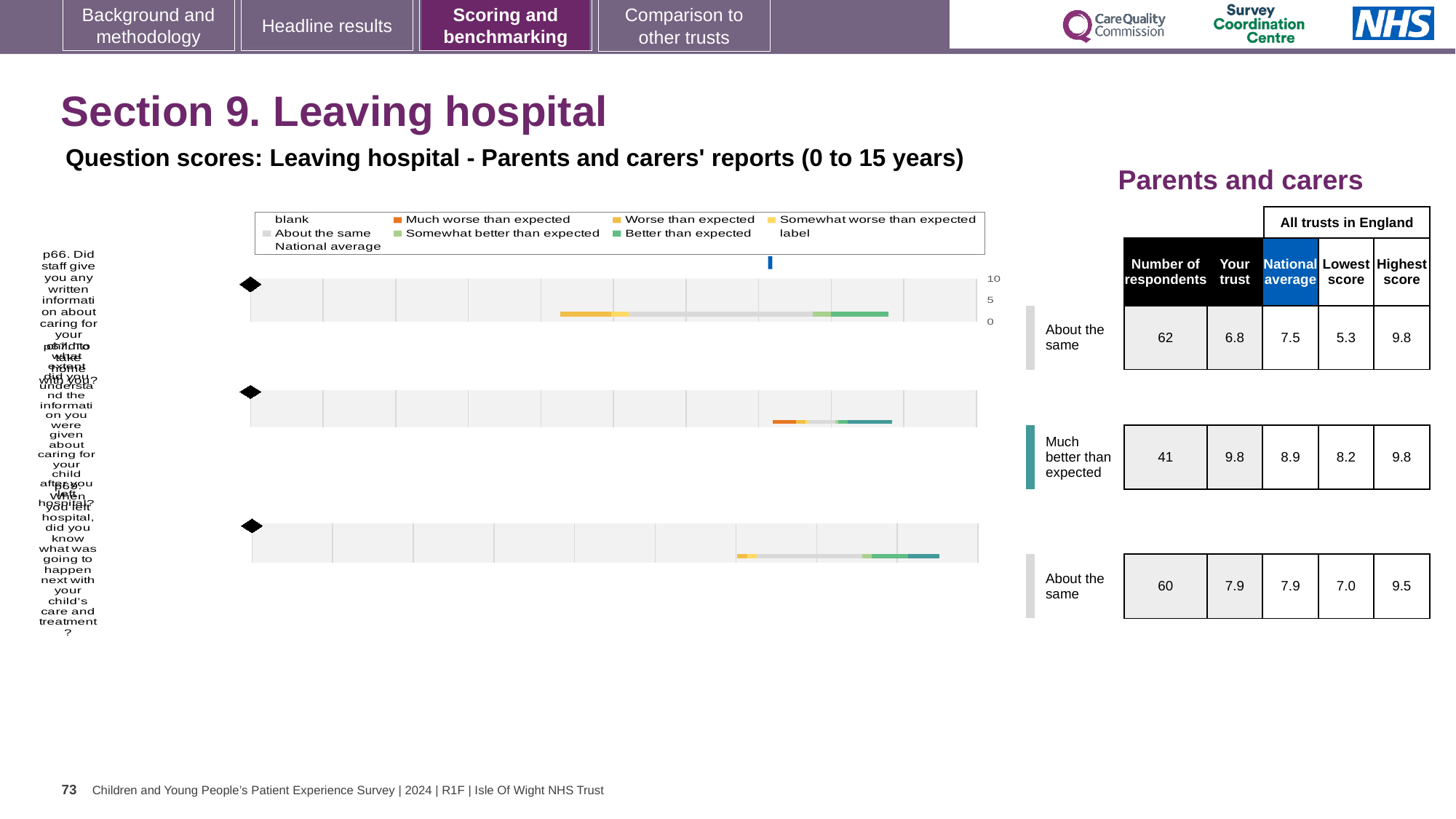
What is the 'Your trust' score for the middle chart's question? 9.8 What is the highest score across all trusts in England for the top chart's question? 9.8 For the middle chart's question, what is the difference between the 'Your trust' score and the national average? 0.9 How many question charts are shown on the slide? 3 What is the lowest score across all trusts in England for the middle chart's question? 8.2 What benchmark category is given for the middle chart's question? Much better than expected Which of the three questions has the highest 'Your trust' score? The middle one (Much better than expected), 9.8 What kind of chart is used to show the question scores? Bar chart What is the national average for the bottom chart's question? 7.9 In the table next to the charts, how many respondents are listed for the top chart's question? 62 For the top chart's question, which is larger: the 'Your trust' score or the national average? National average (7.5) Is the 'Your trust' value for the top chart's question greater or less than 5? greater